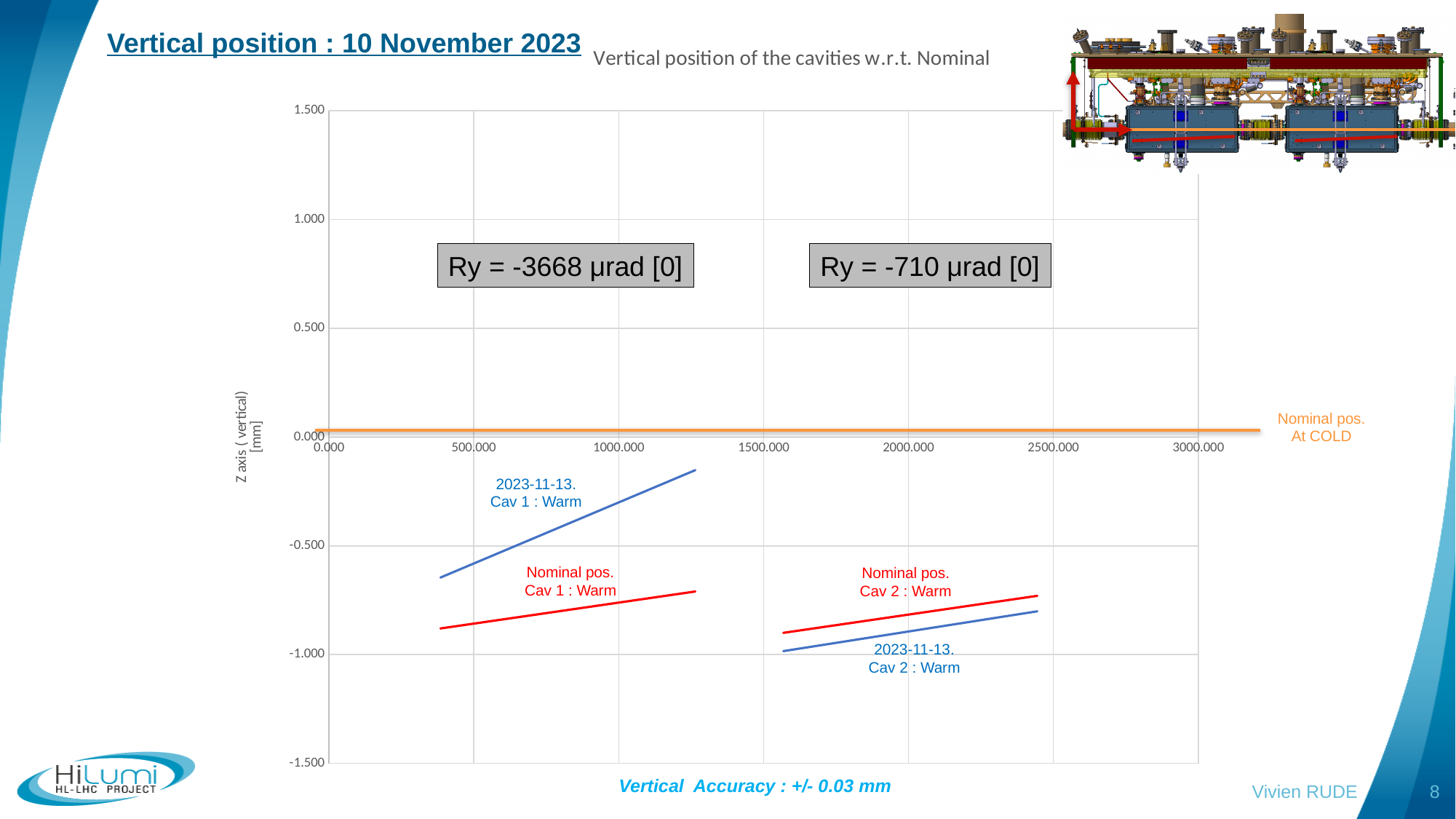
Which line is higher on the chart: '2023-11-13. Cav 1 : Warm' or 'Nominal pos. Cav 1 : Warm'? 2023-11-13. Cav 1 : Warm Which labelled line is the lowest on the chart? 2023-11-13. Cav 2 : Warm Which labelled line is the highest on the chart? Nominal pos. At COLD Is the value of the '2023-11-13. Cav 1 : Warm' line at its right end greater or less than -0.500? greater What is the label of the vertical axis of the chart? Z axis ( vertical) [mm] At what value on the vertical axis does the 'Nominal pos. At COLD' line lie? 0.000 What kind of chart is shown on the slide? line chart Is the value of the '2023-11-13. Cav 2 : Warm' line at its left end greater or less than -0.500? less Which line is higher on the chart: '2023-11-13. Cav 2 : Warm' or 'Nominal pos. Cav 2 : Warm'? Nominal pos. Cav 2 : Warm What is the title of the chart? Vertical position of the cavities w.r.t. Nominal What Ry value is annotated above the Cav 1 lines on the chart? -3668 µrad [0] Does the line labelled '2023-11-13. Cav 1 : Warm' rise or fall as the x value increases? rise